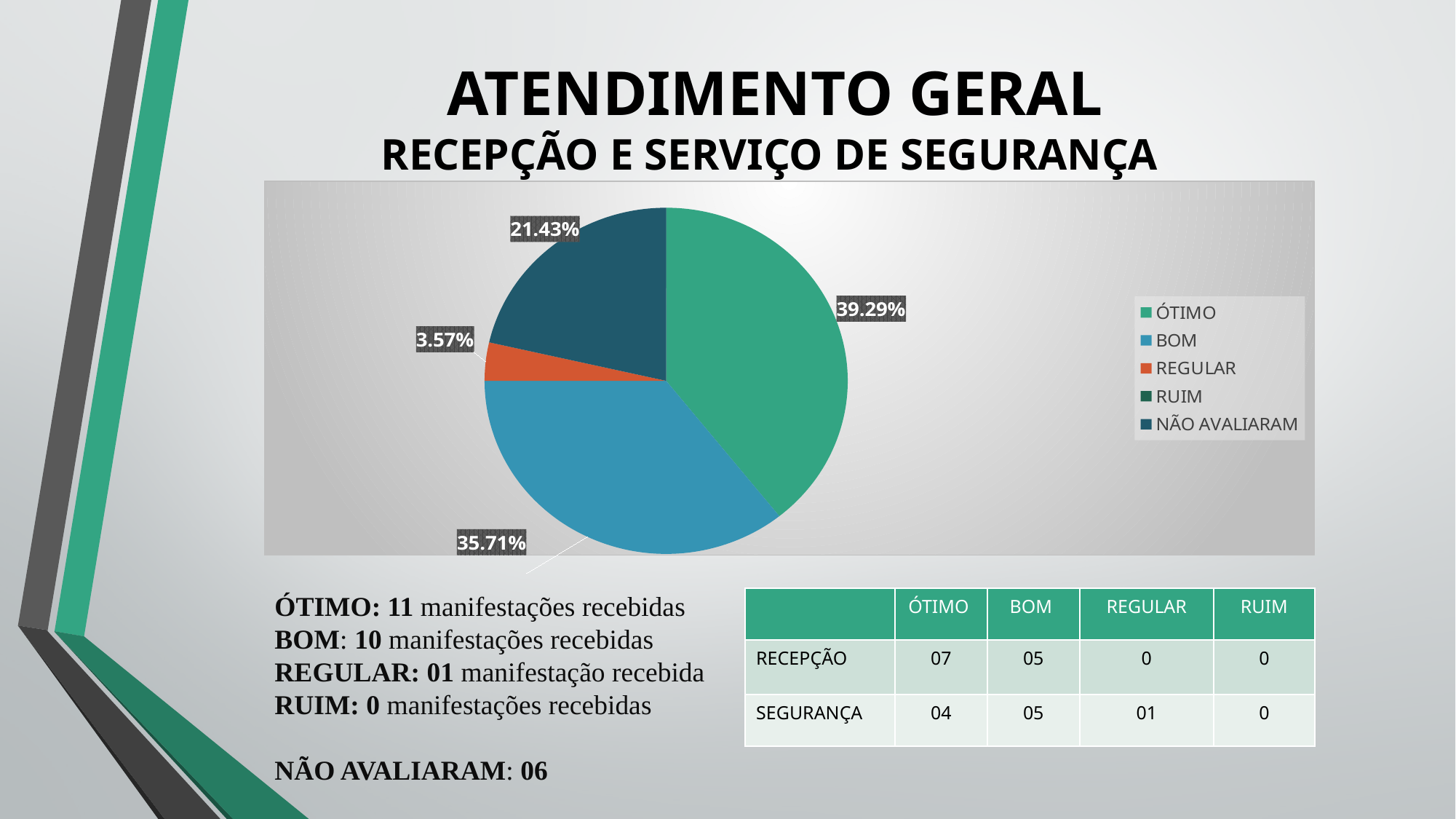
What colour is the ÓTIMO slice in the pie chart? Green Which category has the largest slice in the pie chart? ÓTIMO What percentage of the pie chart is labelled for ÓTIMO? 39.29% What percentage of the pie chart is labelled for REGULAR? 3.57% What is the difference in percentage points between the ÓTIMO and BOM slices? 3.58% What is the difference in percentage points between the NÃO AVALIARAM and REGULAR slices? 17.86% How many entries does the legend of the pie chart list? 5 Which labelled slice in the pie chart is the smallest? REGULAR What percentage of the pie chart is labelled for BOM? 35.71% Which slice is larger, BOM or NÃO AVALIARAM? BOM What percentage of the pie chart is labelled for NÃO AVALIARAM? 21.43% What type of chart is shown on the slide? Pie chart